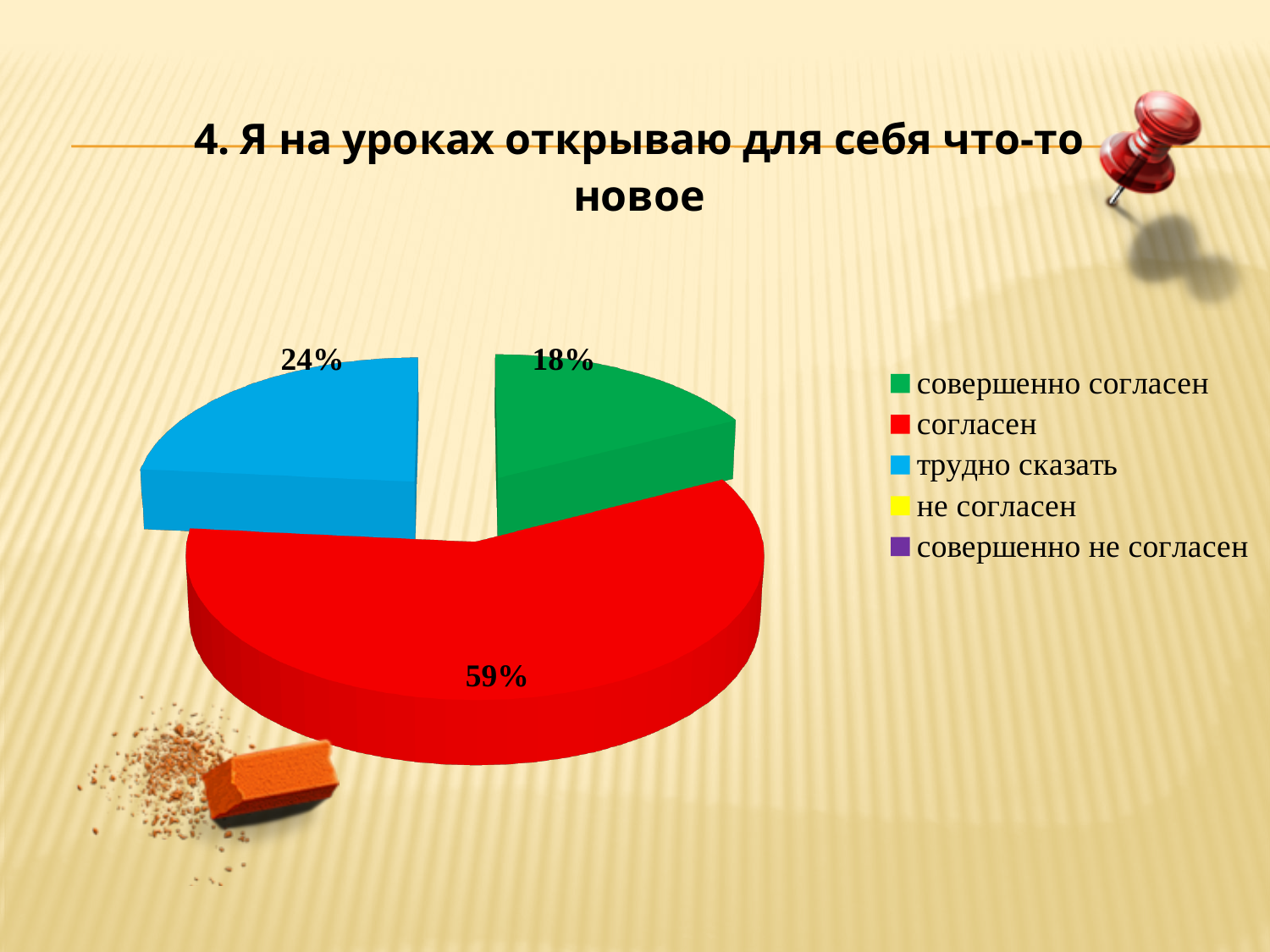
What percentage is shown for the "трудно сказать" slice? 24% What percentage of the pie is labelled for "согласен"? 59% Which response has the largest slice of the pie? согласен Which slice is larger, "трудно сказать" or "совершенно согласен"? трудно сказать What is the difference in percentage points between the "трудно сказать" slice and the "совершенно согласен" slice? 6 What colour is the "согласен" slice? red How many entries does the legend list? 5 What percentage is shown for the "совершенно согласен" slice? 18% What kind of chart is shown on the slide? pie chart What is the title of the slide above the chart? 4. Я на уроках открываю для себя что-то новое Which of the labelled slices is the smallest? совершенно согласен What is the difference in percentage points between the "согласен" slice and the "трудно сказать" slice? 35